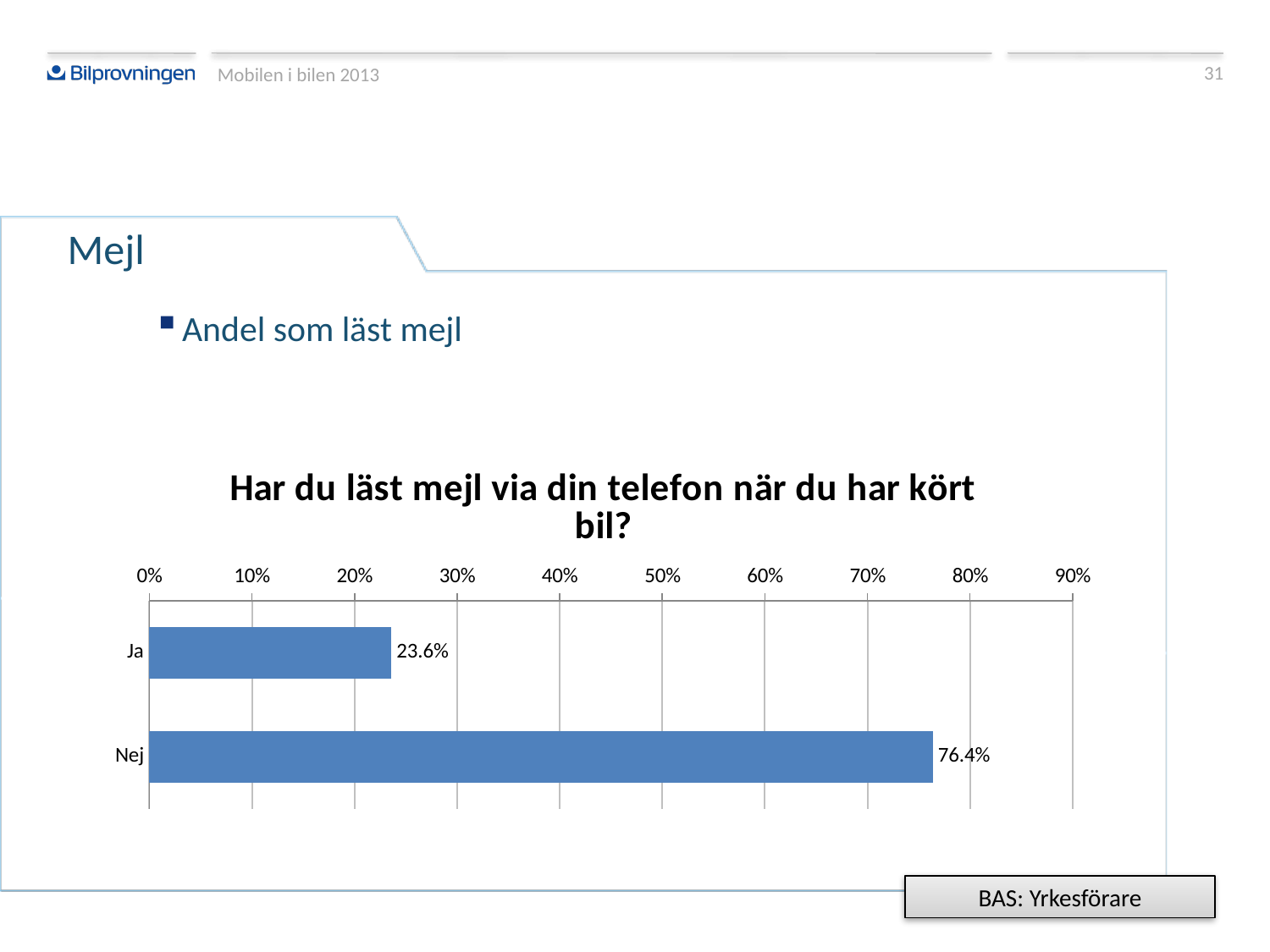
What is the difference between the values for "Nej" and "Ja"? 52.8% Is the value for "Nej" greater or less than 70%? greater What is the total of the values for "Ja" and "Nej"? 100.0% Which category has the highest value? Nej What is the value for "Nej"? 76.4% Which category has the lowest value? Ja What is the title of the chart? Har du läst mejl via din telefon när du har kört bil? What kind of chart is shown on the slide? bar chart How many categories are shown in the chart? 2 What is the value for "Ja"? 23.6% Which is larger, the value for "Ja" or the value for "Nej"? Nej Is the value for "Ja" greater or less than 30%? less